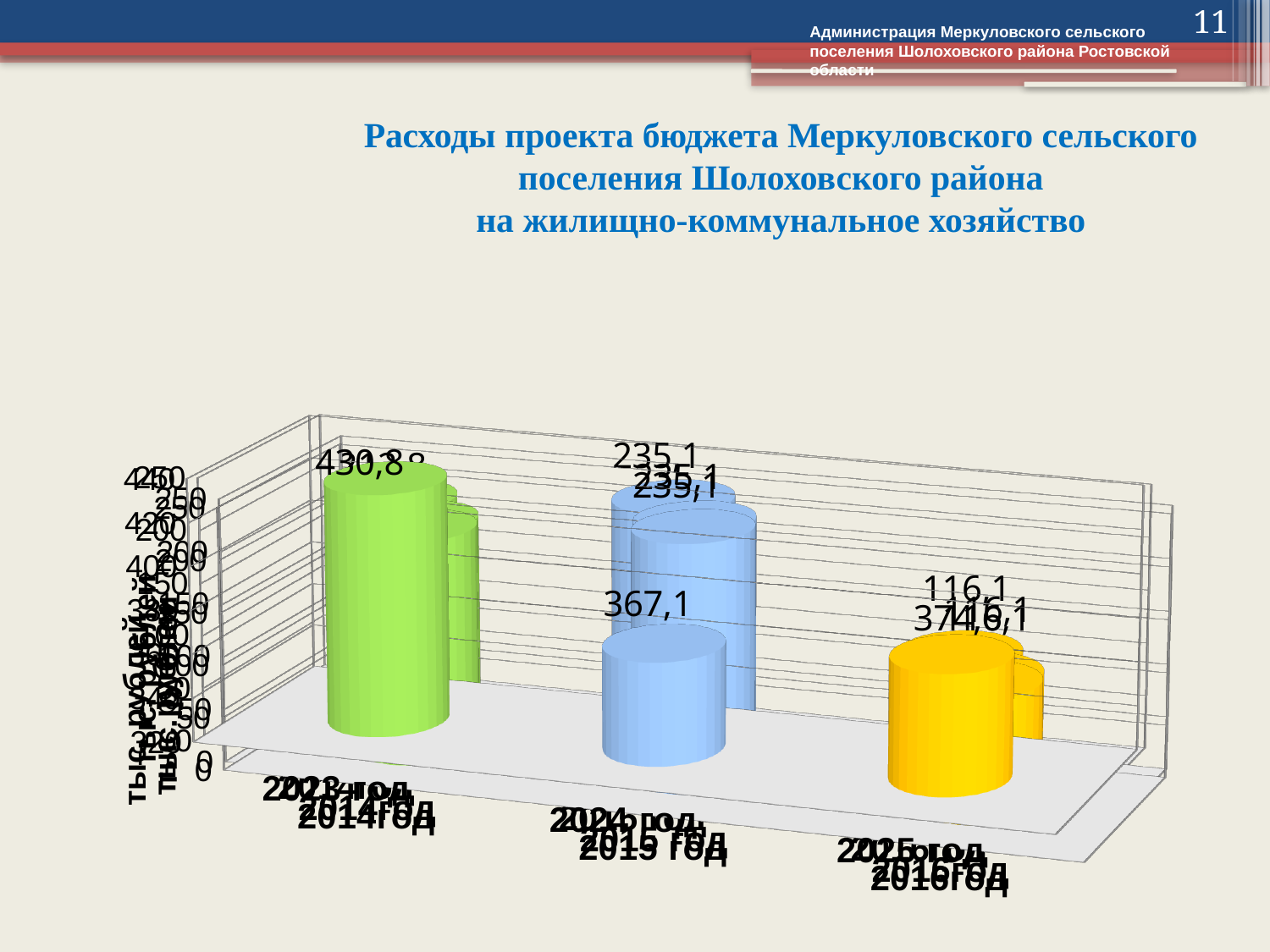
What value is labelled on the rear blue cylinder in the chart? 235,1 How many different colours of cylinders are shown in the chart? 3 What is the title of the chart on the slide? Расходы проекта бюджета Меркуловского сельского поселения Шолоховского района на жилищно-коммунальное хозяйство What is the difference between the green cylinder value (430,8) and the front blue cylinder value (367,1)? 63,7 What value is labelled on the front blue cylinder in the chart? 367,1 Which is larger: the value on the green cylinder (430,8) or the value on the front blue cylinder (367,1)? green cylinder (430,8) Which coloured cylinder in the front row is the tallest? green What kind of chart is shown on the slide? bar chart What value is labelled on the green cylinder in the chart? 430,8